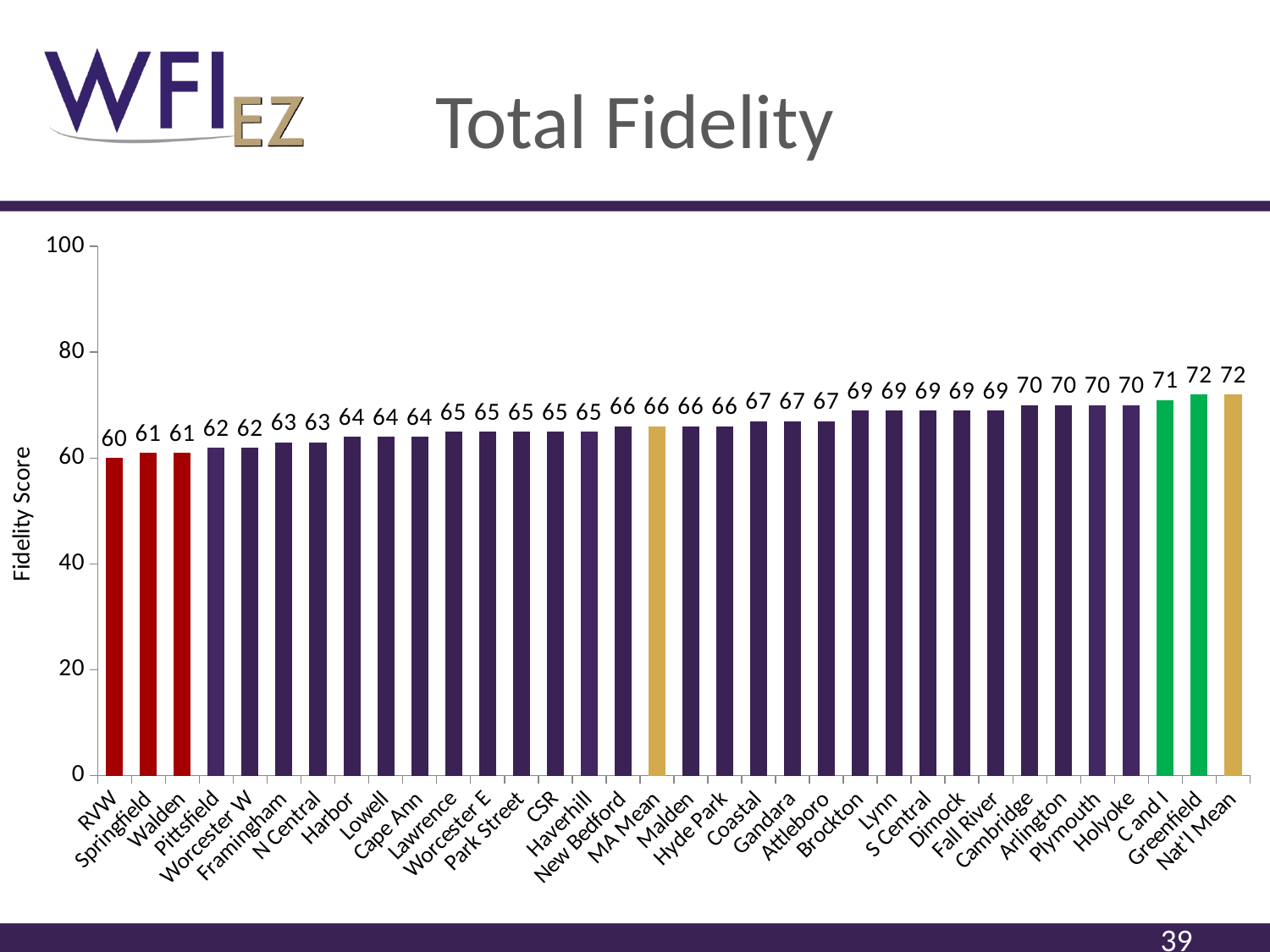
What is the Fidelity Score for Nat'l Mean? 72 How much higher is Greenfield's Fidelity Score than RVW's? 12 What is the Fidelity Score for Holyoke? 70 Is the value for Cambridge greater or less than 60? greater What is the Fidelity Score for Brockton? 69 What is the Fidelity Score for MA Mean? 66 What is the difference between the Nat'l Mean and the MA Mean Fidelity Scores? 6 How many bars are shown in the chart? 34 Which has a higher Fidelity Score, Lowell or Lynn? Lynn Do the Fidelity Scores rise or fall from left to right across the chart? Rise What type of chart is shown on the slide? Bar chart Which site has the lowest Fidelity Score? RVW